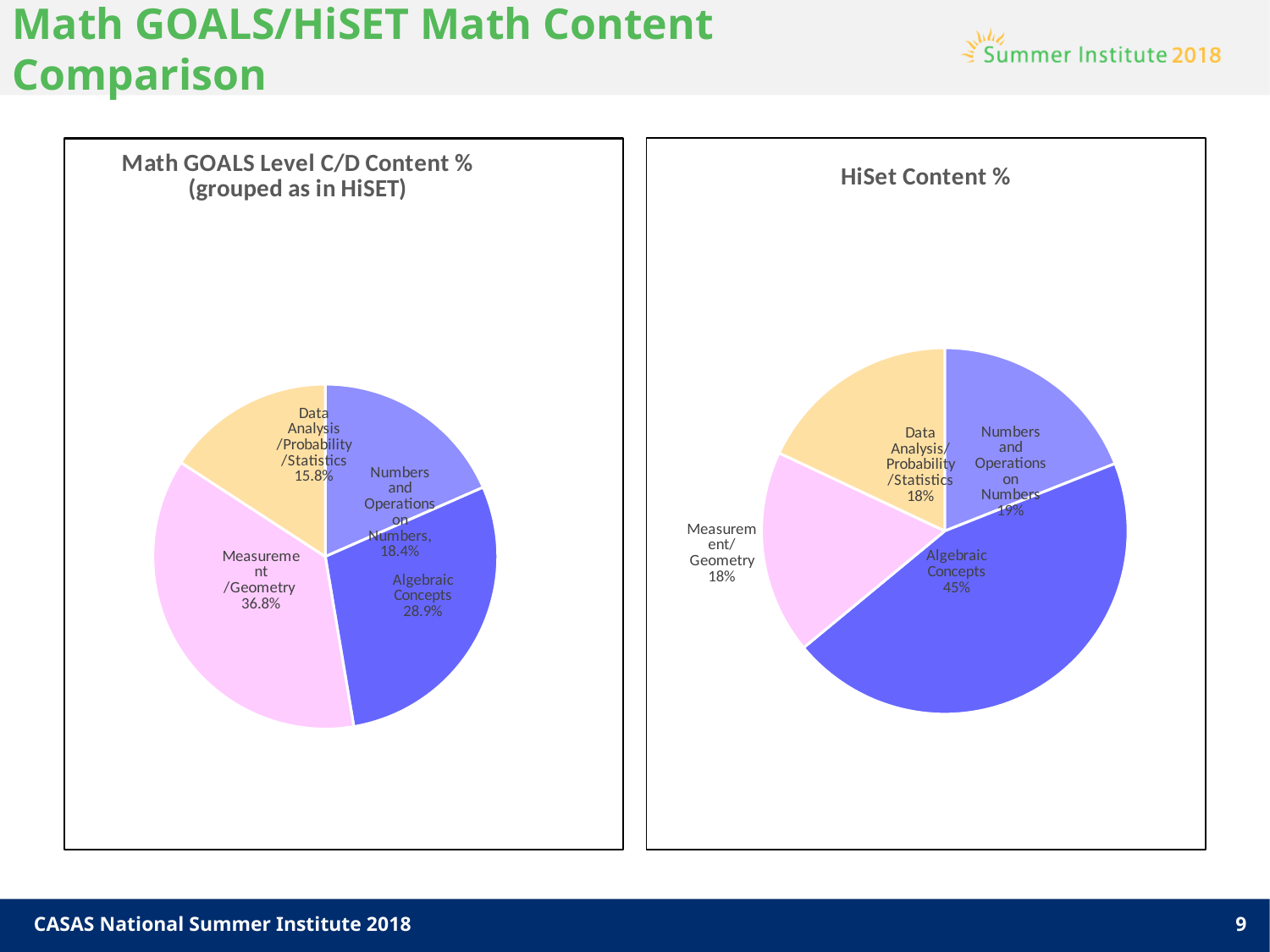
How many categories does the HiSet Content % chart show? 4 In the Math GOALS Level C/D Content % chart, what percentage is Data Analysis/Probability/Statistics? 15.8% In the HiSet Content % chart, what percentage is Algebraic Concepts? 45% What type of chart is the Math GOALS Level C/D Content % chart? Pie chart In the HiSet Content % chart, what percentage is Numbers and Operations on Numbers? 19% In the HiSet Content % chart, what is the difference between Algebraic Concepts and Measurement/Geometry? 27% In the Math GOALS Level C/D Content % chart, which category has the largest share? Measurement/Geometry In the Math GOALS Level C/D Content % chart, what percentage is Algebraic Concepts? 28.9% In the Math GOALS Level C/D Content % chart, what percentage is Measurement/Geometry? 36.8% In the Math GOALS Level C/D Content % chart, what is the difference between Measurement/Geometry and Algebraic Concepts? 7.9% In the HiSet Content % chart, which category has the largest share? Algebraic Concepts In the Math GOALS Level C/D Content % chart, which category has the smallest share? Data Analysis/Probability/Statistics